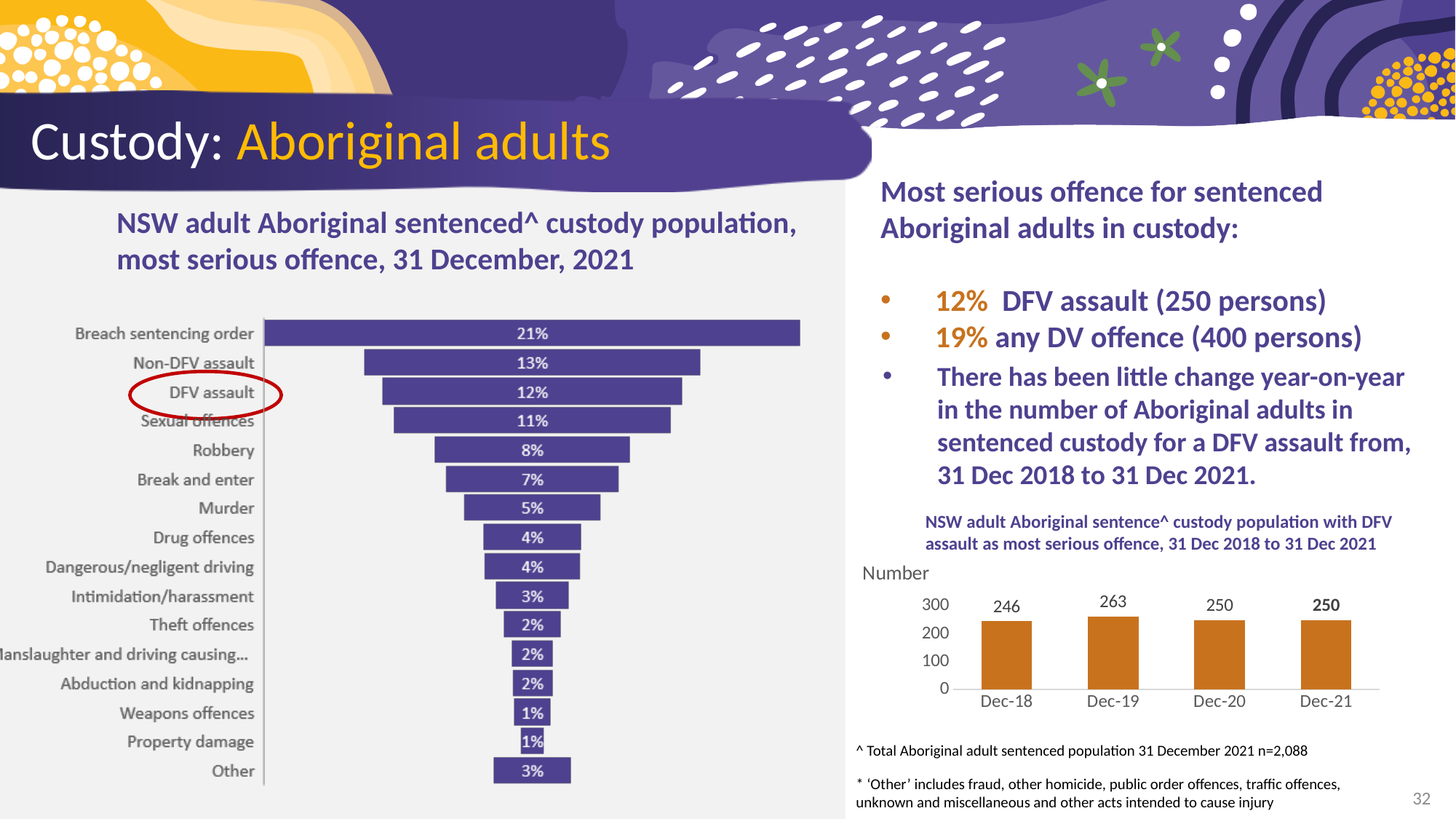
In the chart 'NSW adult Aboriginal sentence^ custody population with DFV assault as most serious offence, 31 Dec 2018 to 31 Dec 2021', what is the difference between the Dec-19 and Dec-18 values? 17 How many offence categories are shown in the chart 'NSW adult Aboriginal sentenced^ custody population, most serious offence, 31 December, 2021'? 16 What kind of chart is the 'NSW adult Aboriginal sentenced^ custody population, most serious offence, 31 December, 2021' chart? Bar chart In the chart 'NSW adult Aboriginal sentenced^ custody population, most serious offence, 31 December, 2021', which is larger: Sexual offences or Break and enter? Sexual offences In the chart 'NSW adult Aboriginal sentenced^ custody population, most serious offence, 31 December, 2021', what is the difference in percentage points between Non-DFV assault and Robbery? 5 percentage points In the chart 'NSW adult Aboriginal sentence^ custody population with DFV assault as most serious offence, 31 Dec 2018 to 31 Dec 2021', which period has the lowest value? Dec-18 In the chart 'NSW adult Aboriginal sentence^ custody population with DFV assault as most serious offence, 31 Dec 2018 to 31 Dec 2021', what is the label on the vertical axis? Number In the chart 'NSW adult Aboriginal sentenced^ custody population, most serious offence, 31 December, 2021', what percentage is shown for Breach sentencing order? 21% How many periods are plotted in the chart 'NSW adult Aboriginal sentence^ custody population with DFV assault as most serious offence, 31 Dec 2018 to 31 Dec 2021'? 4 In the chart 'NSW adult Aboriginal sentenced^ custody population, most serious offence, 31 December, 2021', which offence category has the highest percentage? Breach sentencing order In the chart 'NSW adult Aboriginal sentence^ custody population with DFV assault as most serious offence, 31 Dec 2018 to 31 Dec 2021', what is the value for Dec-19? 263 In the chart 'NSW adult Aboriginal sentenced^ custody population, most serious offence, 31 December, 2021', what percentage is shown for DFV assault? 12%